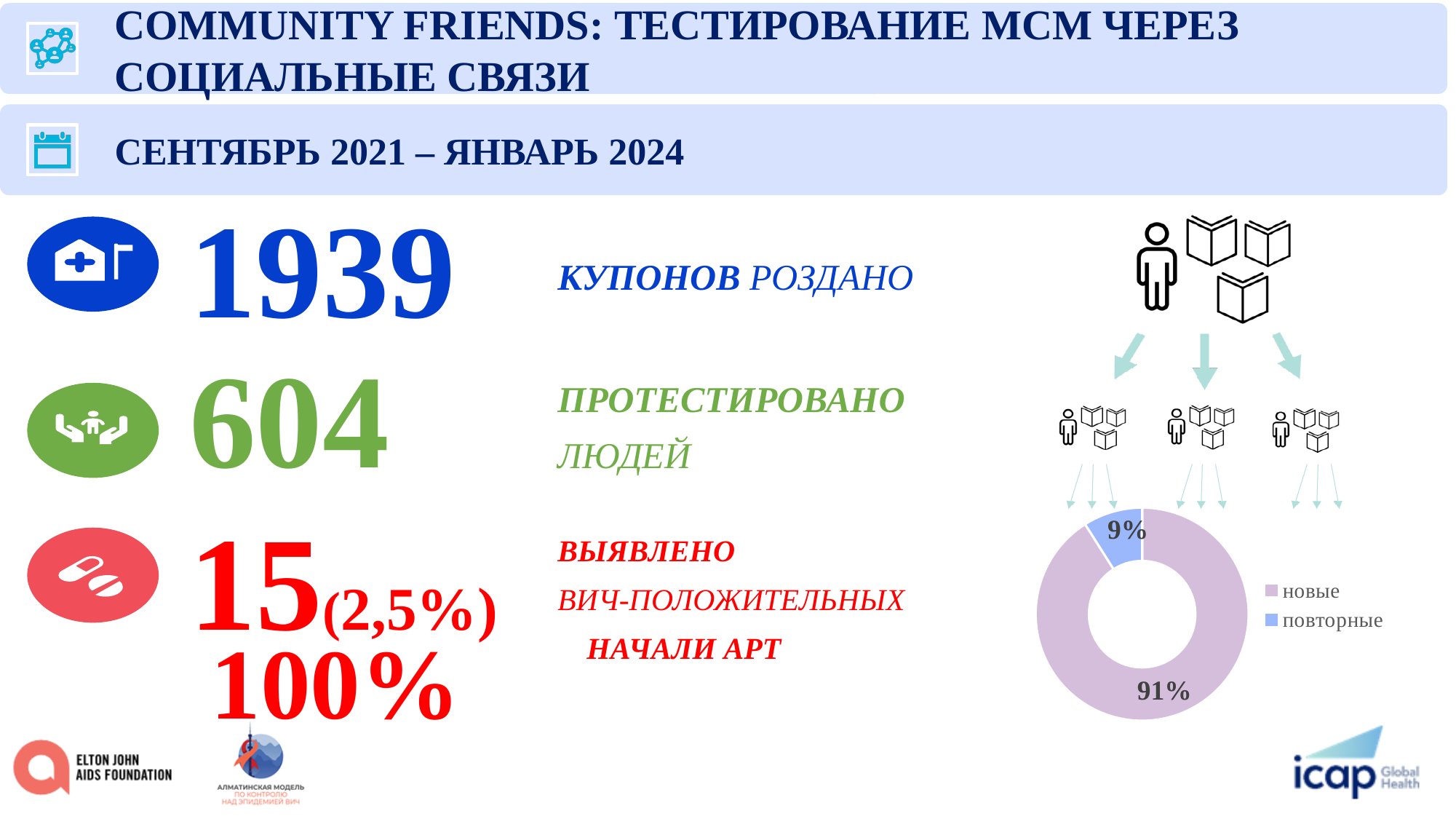
In the donut chart, which is larger: 'новые' or 'повторные'? новые In the donut chart, what share is labelled for the 'новые' slice? 91% What colour is the 'повторные' slice in the donut chart? blue Which slice of the donut chart is the smallest? повторные What is the difference in percentage points between the 'новые' and 'повторные' slices of the donut chart? 82 Which slice of the donut chart is the largest? новые What kind of chart is shown on the right side of the slide? pie chart (donut) In the donut chart, what share is labelled for the 'повторные' slice? 9% How many entries does the legend of the donut chart list? 2 How many slices does the donut chart have? 2 What colour is the 'новые' slice in the donut chart? light purple